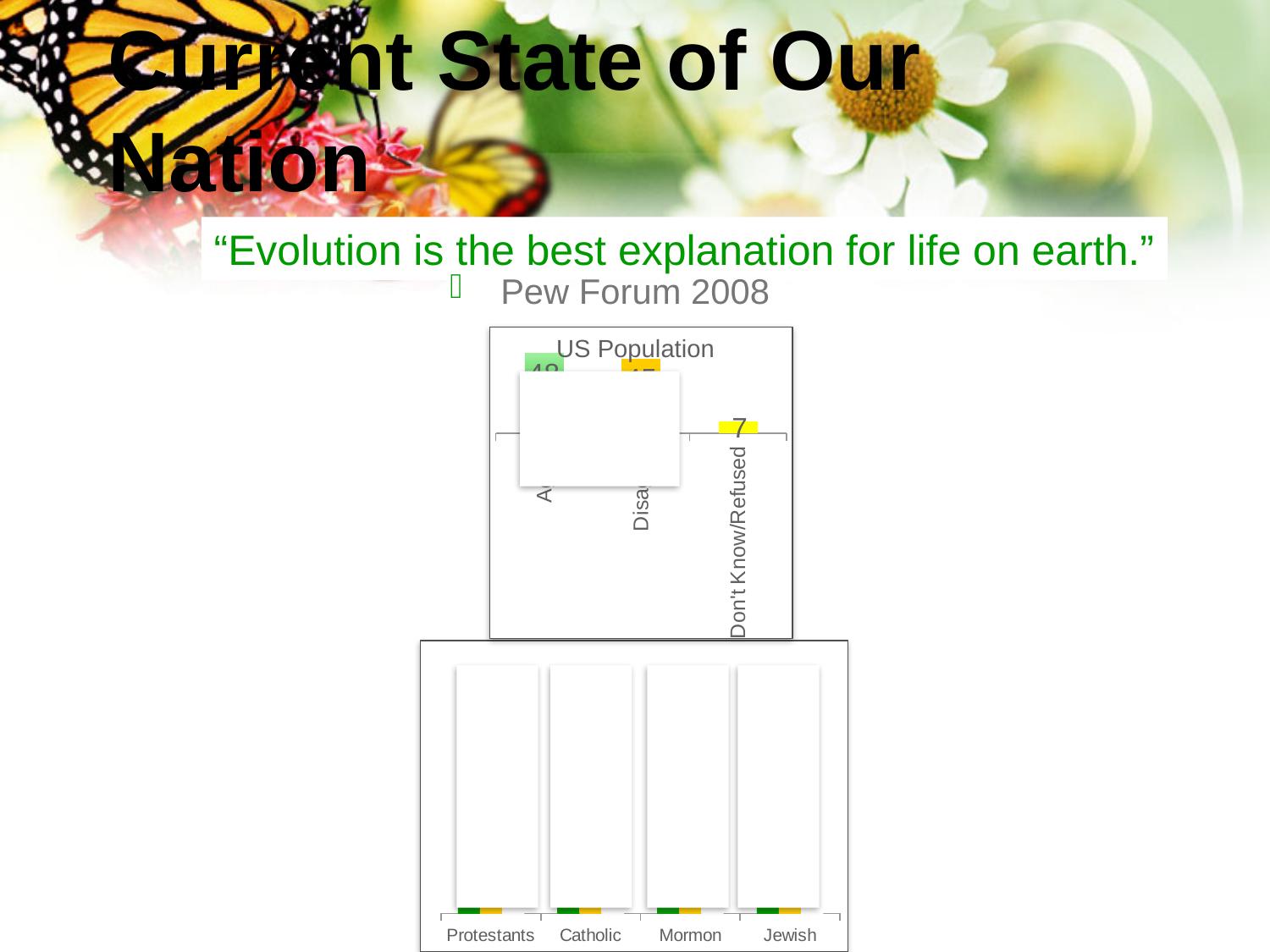
In the lower chart, which category is listed first on the x axis? Protestants How many bars are plotted in the US Population chart? 3 In the lower chart, which category is listed last on the x axis? Jewish How many categories are shown on the x axis of the lower chart? 4 In the US Population chart, which category has the lowest value? Don't Know/Refused What is the title of the upper chart? US Population In the US Population chart, what is the value for Don't Know/Refused? 7 What kind of chart is the US Population chart? bar chart What kind of chart is the lower chart? bar chart